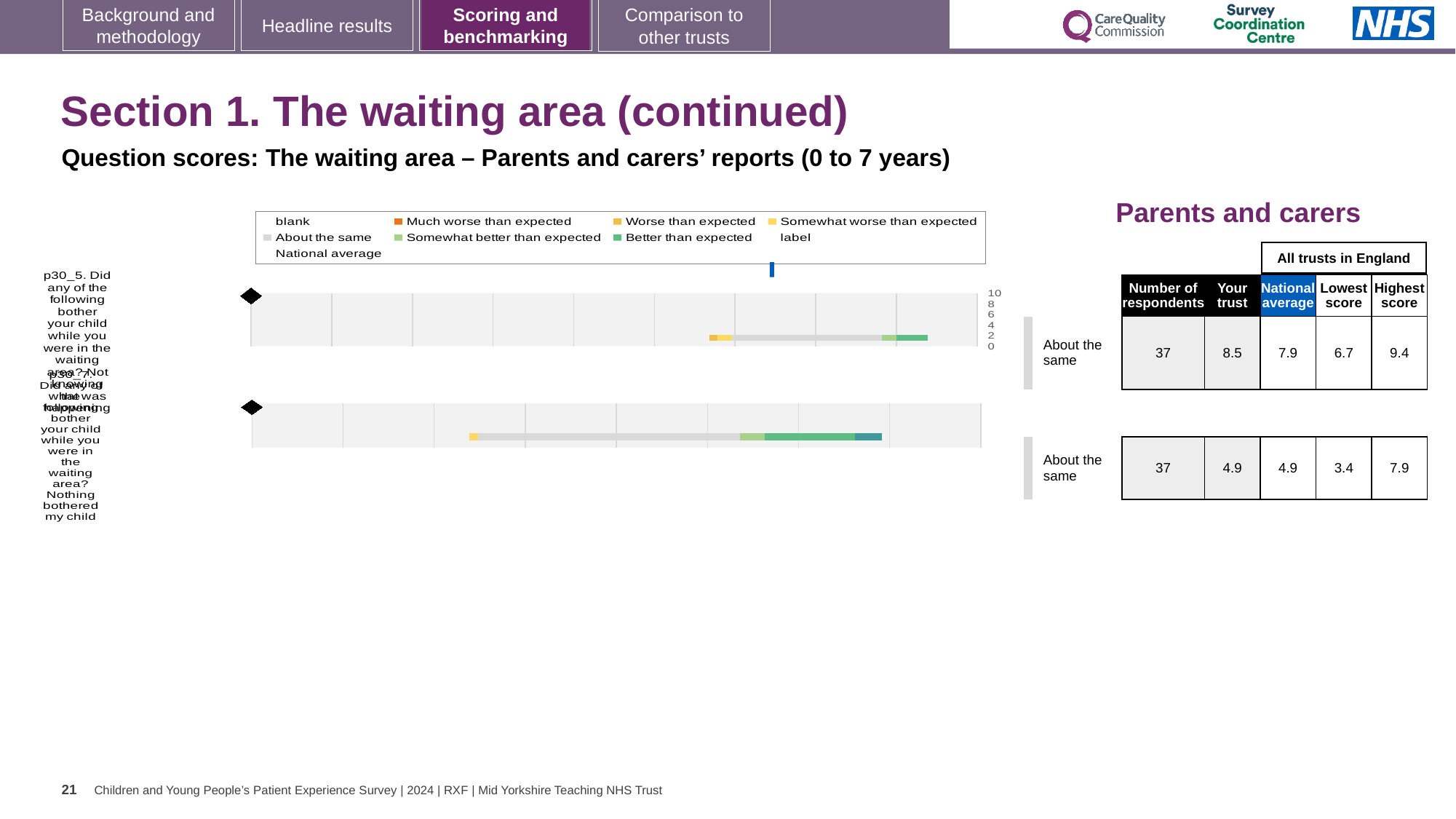
What benchmark category is shown for question p30_7? About the same How many questions (bars) are plotted on the slide? 2 For question p30_5, which is larger: the 'Your trust' score or the national average? Your trust What is the difference between the highest and lowest scores for question p30_7? 4.5 What is the highest score among all trusts in England for question p30_7? 7.9 What is the difference between the 'Your trust' score and the national average for question p30_5? 0.6 What kind of chart is used to show the question scores on this slide? bar chart How many respondents answered question p30_5? 37 What is the national average score for question p30_7 (Nothing bothered my child)? 4.9 What is the lowest score among all trusts in England for question p30_5? 6.7 What is the maximum value shown on the score axis of the charts? 10 What is the 'Your trust' score for question p30_5 (Not knowing what was happening)? 8.5